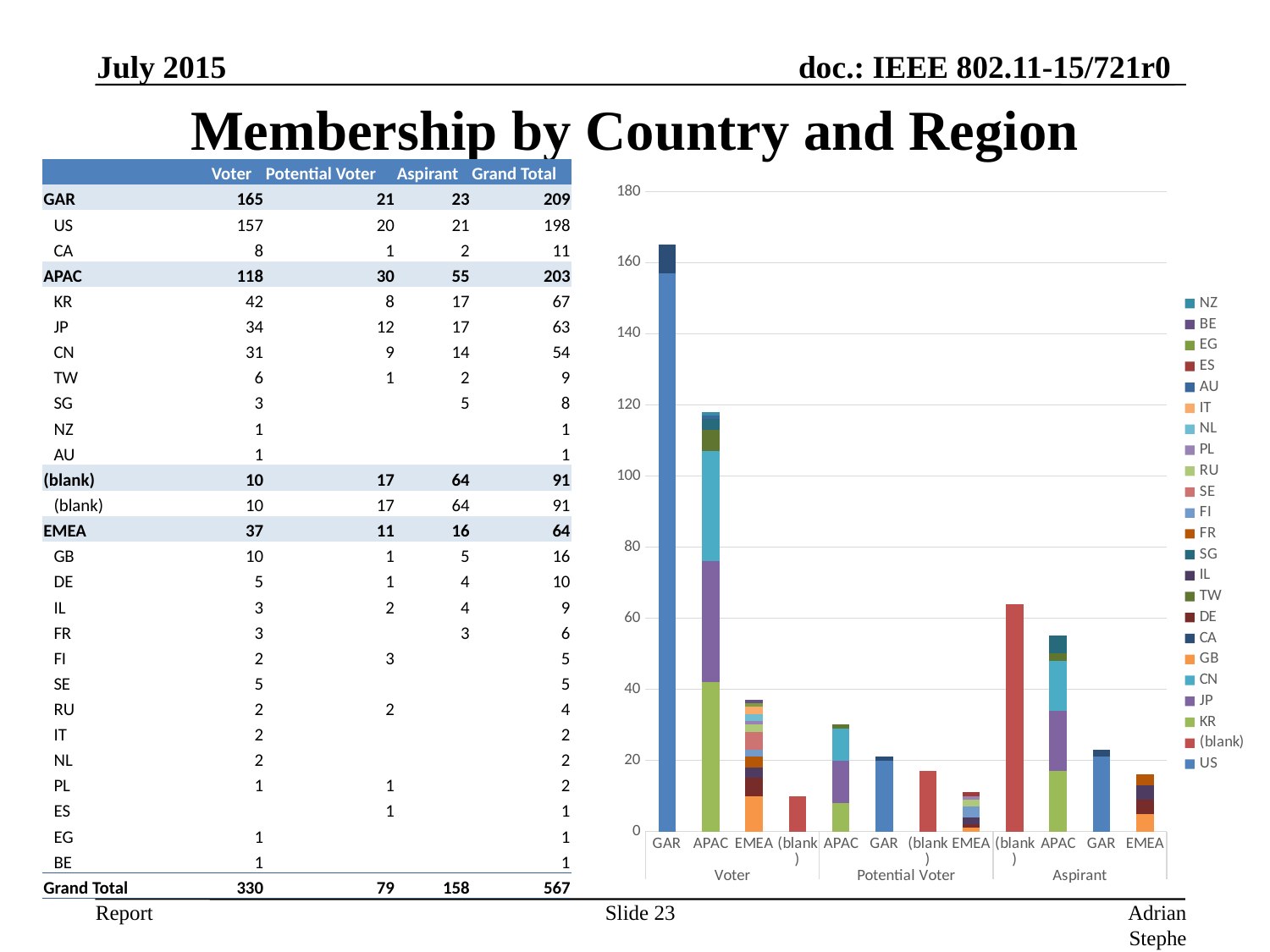
What kind of chart is shown on the slide? bar chart Which bar in the chart is the tallest? GAR under Voter Is the total height of the APAC bar in the Voter group greater or less than 100? greater In the Aspirant group, which bar is taller, APAC or GAR? APAC How many entries does the chart legend list? 23 According to the table, what is the Grand Total for APAC? 203 How many bars are plotted in the chart? 12 In the Potential Voter group, which bar is taller, GAR or APAC? APAC Is the (blank) bar in the Aspirant group greater or less than 40? greater Is the total height of the GAR bar in the Voter group greater or less than 140? greater Within the Aspirant group, which bar is the shortest? EMEA Do the bar heights rise or fall from GAR to (blank) within the Voter group? fall